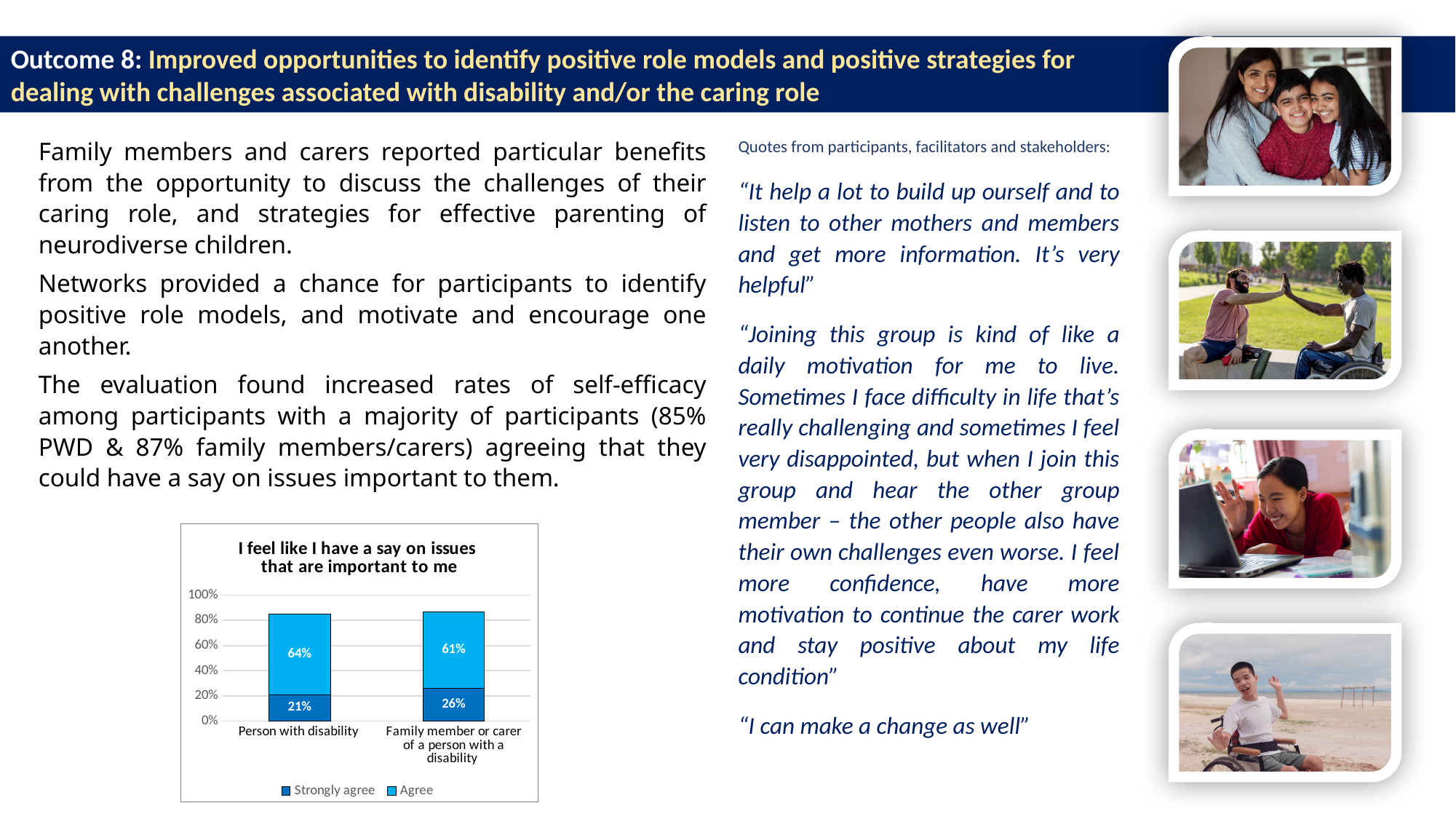
What is the 'Strongly agree' value for 'Person with disability'? 21% What is the 'Agree' value for 'Family member or carer of a person with a disability'? 61% What is the difference between the 'Agree' values for 'Person with disability' and 'Family member or carer of a person with a disability'? 3% Which category has the higher 'Strongly agree' value? Family member or carer of a person with a disability What is the 'Strongly agree' value for 'Family member or carer of a person with a disability'? 26% What type of chart is shown on the slide? Stacked bar chart How many categories are shown on the x axis of the chart? 2 What is the total of the stacked bar for 'Family member or carer of a person with a disability'? 87% What is the 'Agree' value for 'Person with disability'? 64% What is the title of the chart? I feel like I have a say on issues that are important to me How many series does the chart legend list? 2 What is the total of the stacked bar for 'Person with disability'? 85%